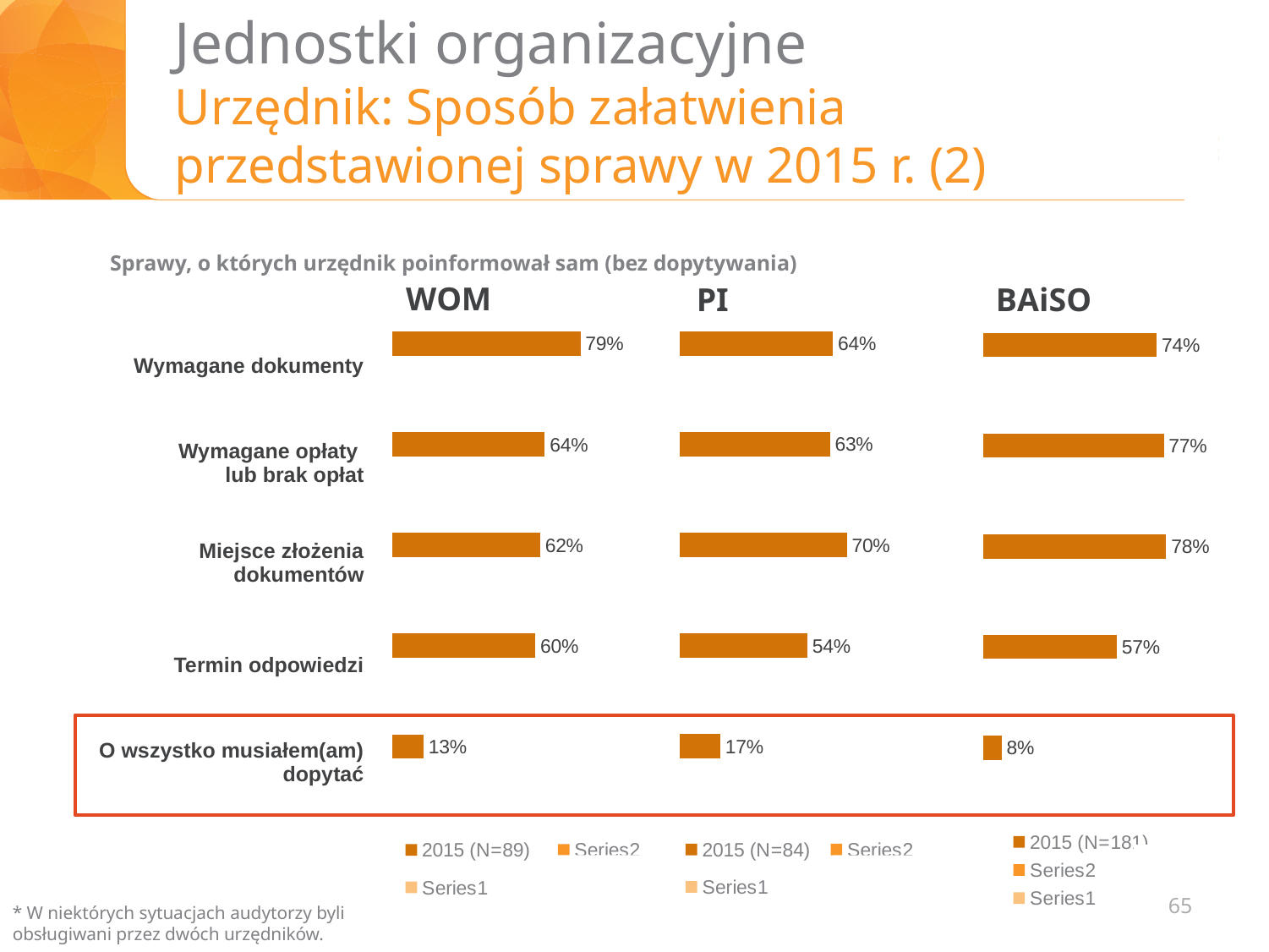
In the BAiSO chart, what is the value for O wszystko musiałem(am) dopytać? 8% What type of chart is the BAiSO chart? bar chart What is the first legend entry of the WOM chart? 2015 (N=89) In the BAiSO chart, which category has the highest value? Miejsce złożenia dokumentów In the WOM chart, what is the difference between Wymagane dokumenty and Termin odpowiedzi? 19% In the BAiSO chart, what is the difference between Wymagane opłaty lub brak opłat and Termin odpowiedzi? 20% How many series does the legend of the PI chart list? 3 In the PI chart, what is the value for Miejsce złożenia dokumentów? 70% How many categories does the WOM chart show? 5 In the WOM chart, what is the value for Wymagane dokumenty? 79% In the PI chart, which is larger: Wymagane dokumenty or Termin odpowiedzi? Wymagane dokumenty In the PI chart, which category has the lowest value? O wszystko musiałem(am) dopytać